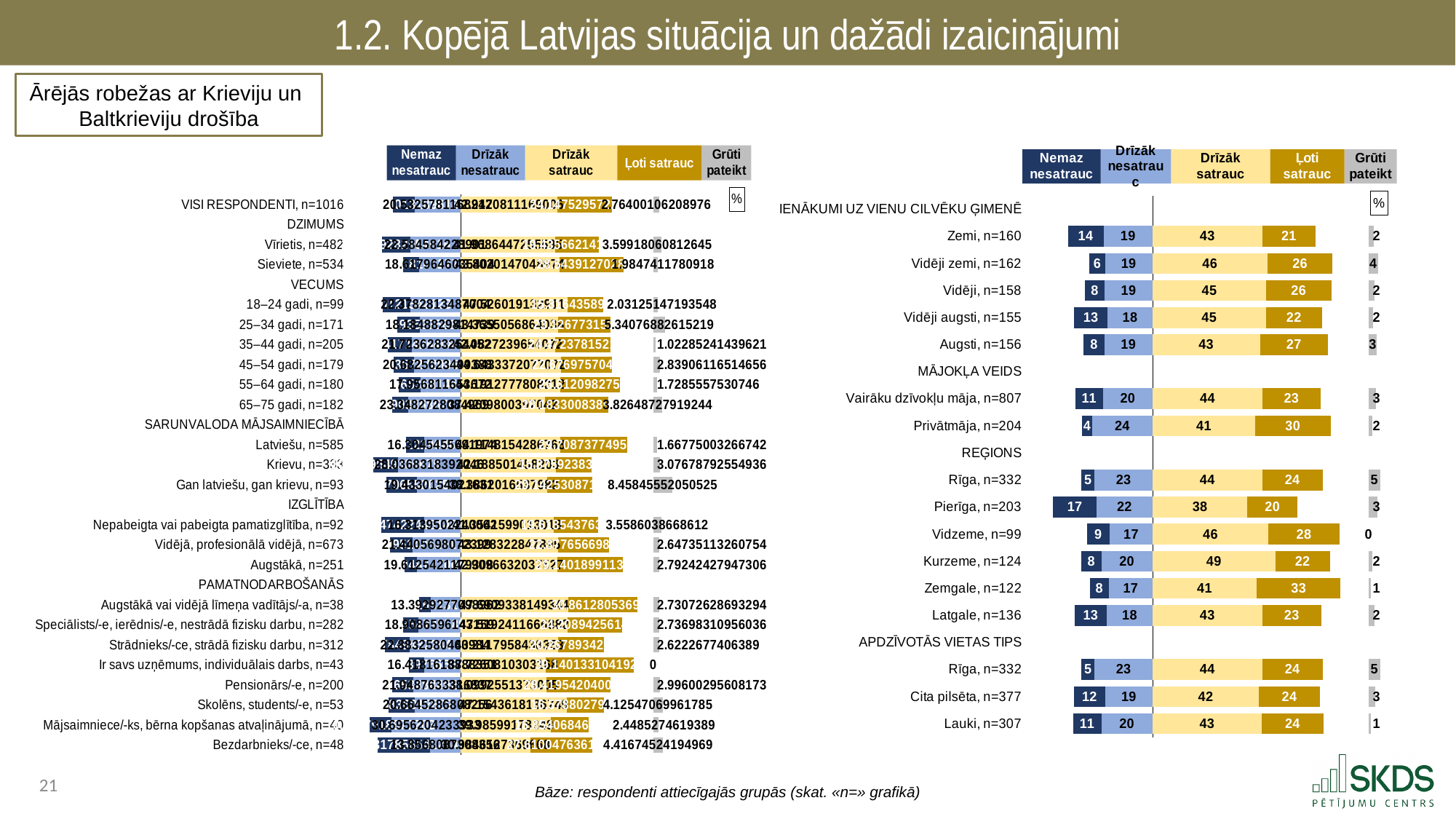
In the right chart, which has a larger 'Nemaz nesatrauc' value: Cita pilsēta, n=377 or Rīga, n=332? Cita pilsēta, n=377 In the right chart, what percentage of respondents with 'Zemi' income (n=160) answered 'Drīzāk satrauc'? 43 What kind of chart is the right chart? Stacked bar chart In the right chart, what is the 'Ļoti satrauc' value for Privātmāja, n=204? 30 In the right chart, what is the 'Grūti pateikt' value for Vidzeme, n=99? 0 How many series does the legend of the right chart list? 5 In the right chart, what is the difference between the 'Ļoti satrauc' values for Zemgale, n=122 and Pierīga, n=203? 13 In the right chart, which region (REĢIONS group) has the highest 'Ļoti satrauc' value? Zemgale, n=122 In the right chart, what is the 'Nemaz nesatrauc' value for Pierīga, n=203? 17 In the right chart, which series is shown in the darkest blue colour? Nemaz nesatrauc In the right chart, which housing type (MĀJOKĻA VEIDS group) has the lower 'Nemaz nesatrauc' value? Privātmāja, n=204 In the right chart, which region (REĢIONS group) has the highest 'Drīzāk satrauc' value? Kurzeme, n=124